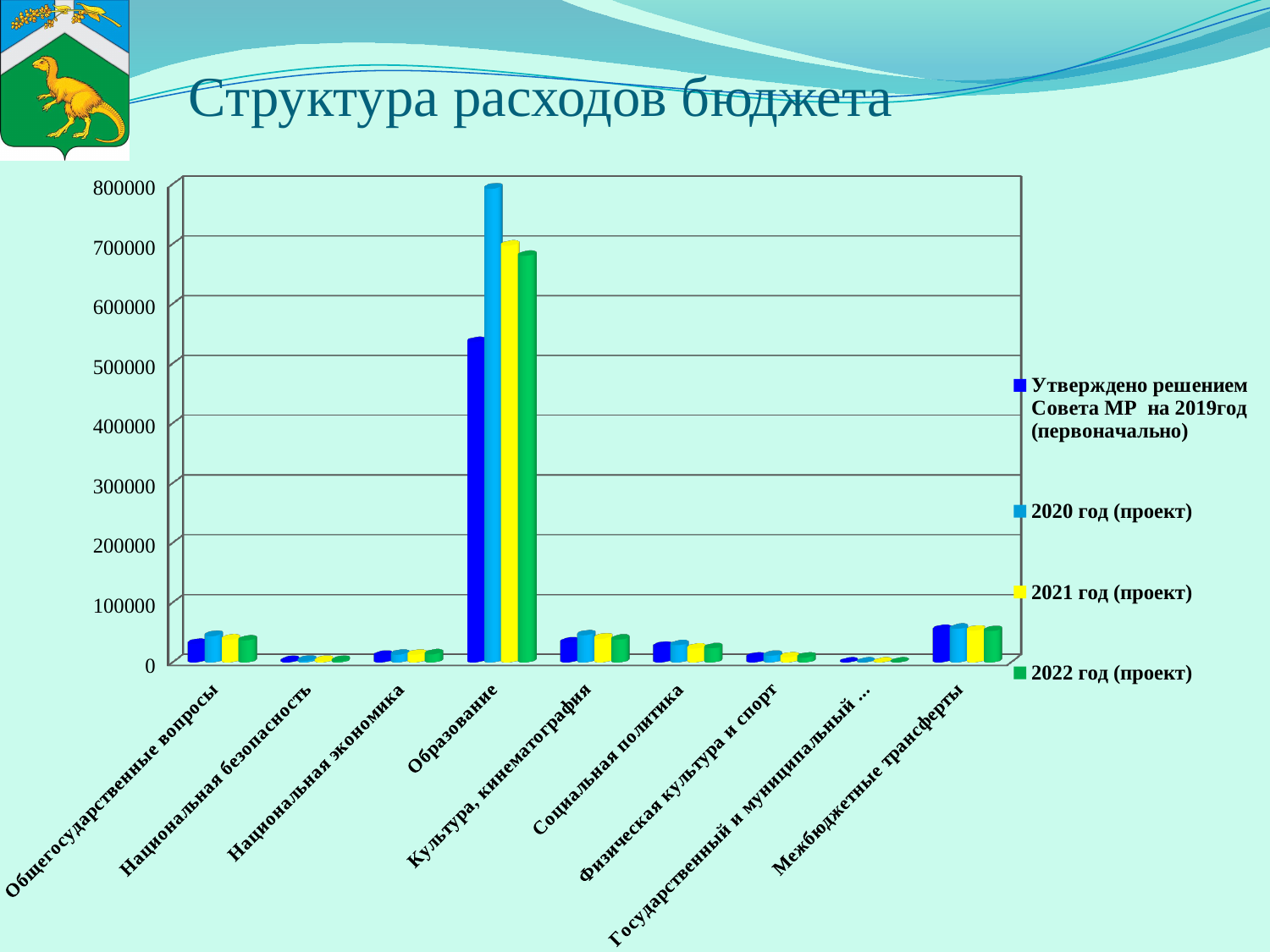
For Образование, which series has the tallest bar? 2020 год (проект) How many expenditure categories are shown along the x axis? 9 Is the value for Образование in the Утверждено решением Совета МР на 2019год (первоначально) series greater or less than 600000? less Is the value for Образование in the 2020 год (проект) series greater or less than 700000? greater Which category has the highest values in the chart? Образование What kind of chart is shown on the slide? bar chart How many series does the legend list? 4 What is the title of the slide? Структура расходов бюджета In the 2020 год (проект) series, which is larger: Общегосударственные вопросы or Национальная безопасность? Общегосударственные вопросы What colour represents the 2022 год (проект) series in the legend? green For Образование, which is larger: the 2020 год (проект) value or the Утверждено решением Совета МР на 2019год (первоначально) value? 2020 год (проект) Is the value for Межбюджетные трансферты in the 2020 год (проект) series greater or less than 100000? less